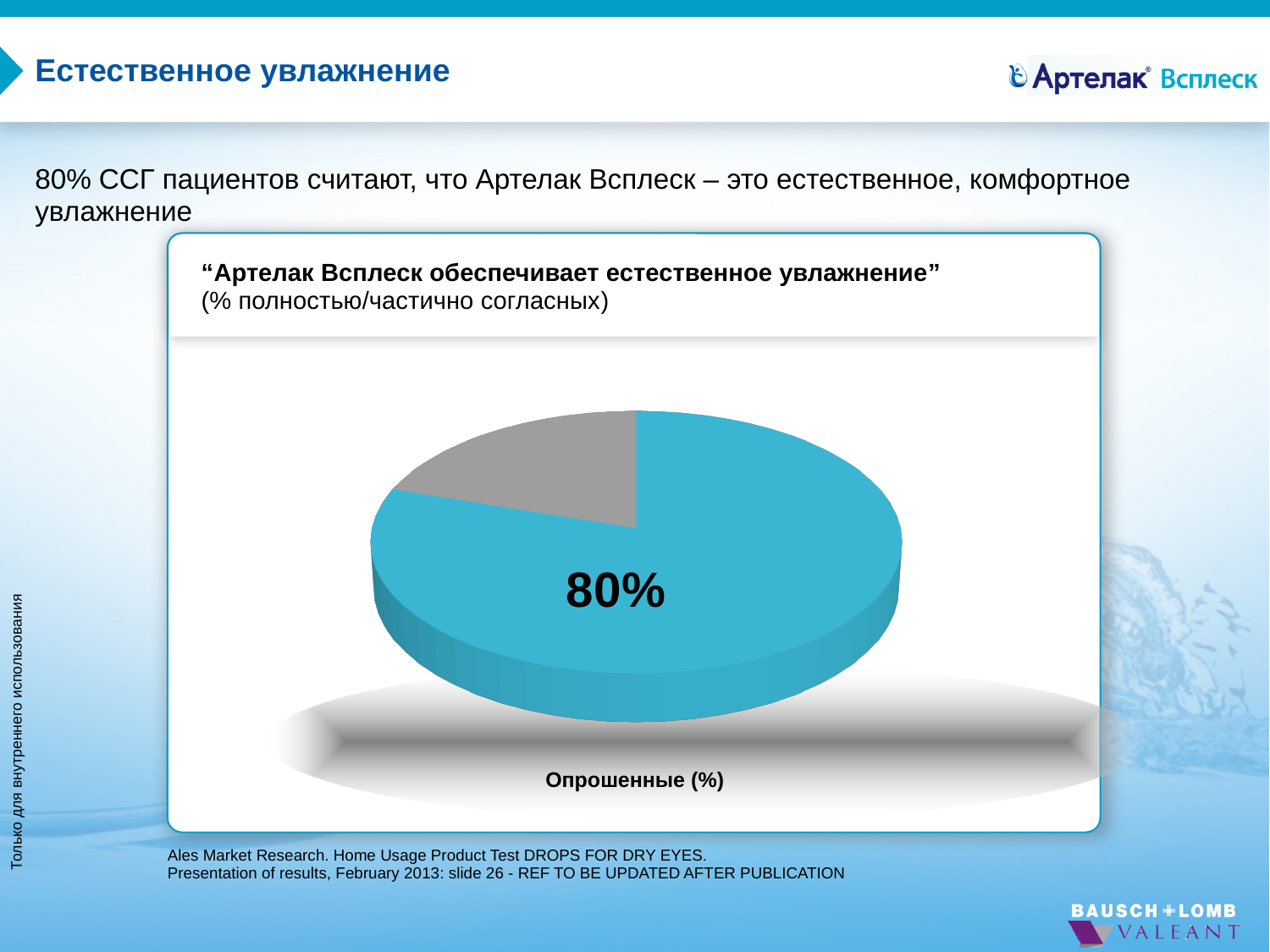
What label is printed below the pie chart? Опрошенные (%) Is the share of the blue slice greater or less than 50%? greater What percentage is printed on the large blue slice of the pie chart? 80% How many slices does the pie chart have? 2 What kind of chart is shown on the slide? pie chart Which slice of the pie chart is larger, the blue one or the grey one? the blue one What is the title of the chart? “Артелак Всплеск обеспечивает естественное увлажнение” (% полностью/частично согласных) Is the share of the grey slice greater or less than 50%? less What share of the pie does the grey slice represent, given the blue slice is 80%? 20%